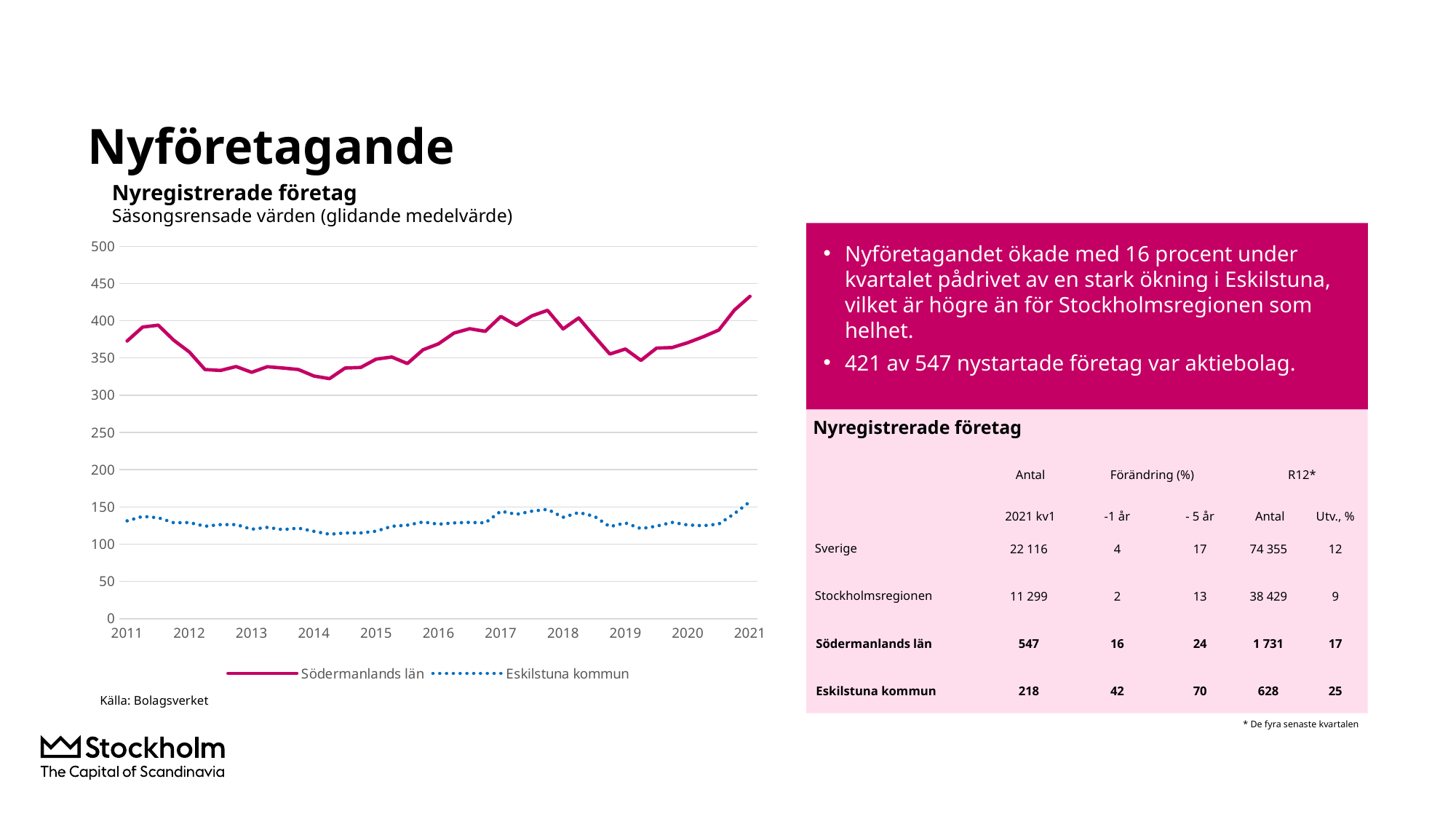
How many series does the chart legend list? 2 Is the value for Södermanlands län at 2014 greater or less than 350? less Is the value for Eskilstuna kommun at 2014 greater or less than 150? less Which series has the higher value at 2021, Södermanlands län or Eskilstuna kommun? Södermanlands län Does the Södermanlands län line rise or fall between 2019 and 2021? Rise How many year labels are shown on the x axis of the chart? 11 Does the Södermanlands län line rise or fall between 2011 and 2014? Fall What is the title of the chart? Nyregistrerade företag Is the value for Södermanlands län at 2021 greater or less than 400? greater Which two series are listed in the chart legend? Södermanlands län and Eskilstuna kommun What kind of chart is shown on the slide? Line chart